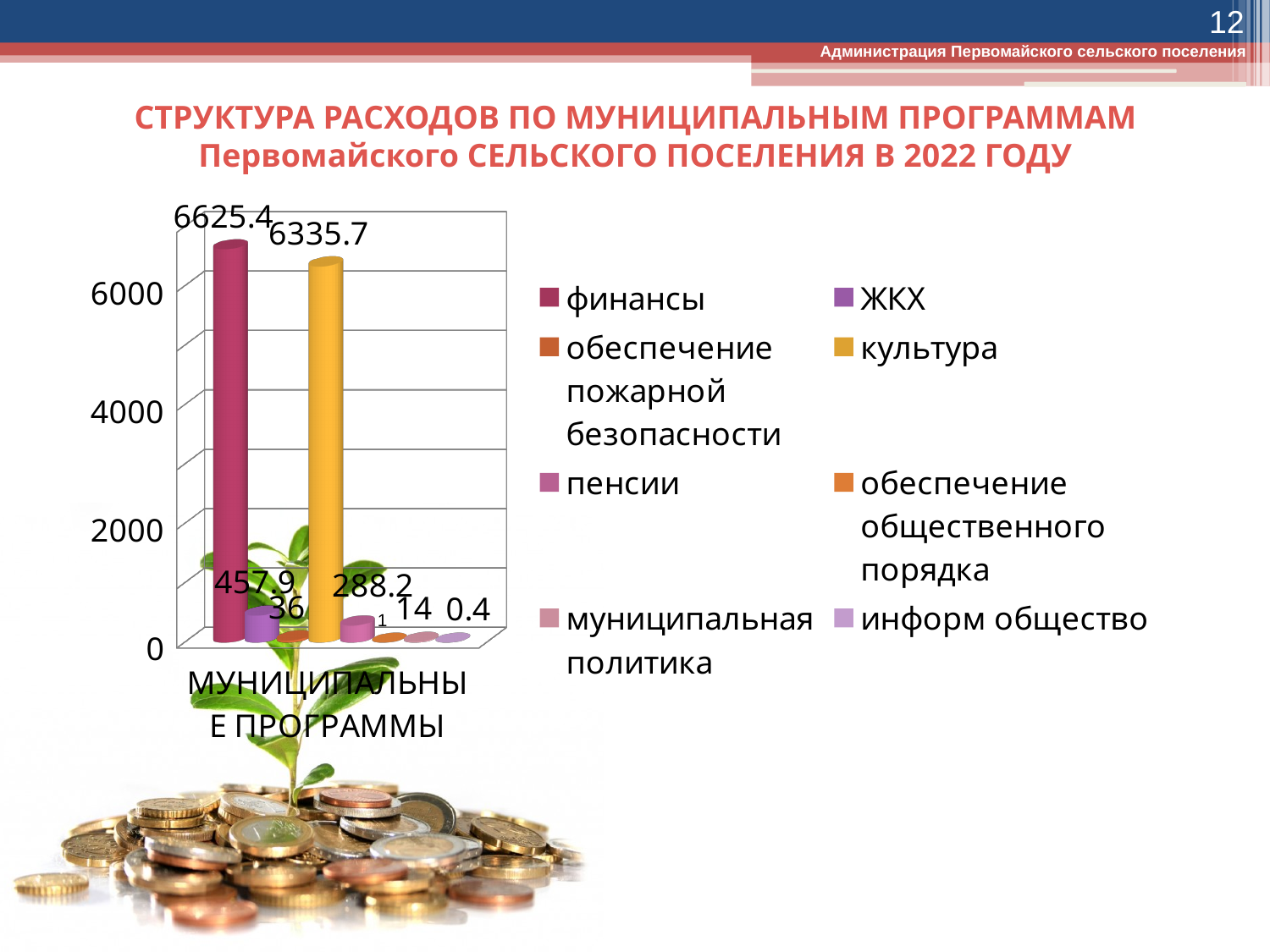
What is the difference between the values for финансы and культура? 289.7 What is the value for ЖКХ? 457.9 What is the value for муниципальная политика? 14 What is the value for культура? 6335.7 Which series has the lowest value? информ общество What is the value for пенсии? 288.2 Which series has the highest value? финансы Is the value for культура greater or less than 6000? greater How many series does the legend list? 8 What kind of chart is shown on the slide? bar chart What is the value for финансы? 6625.4 Which is larger, the value for ЖКХ or the value for пенсии? ЖКХ